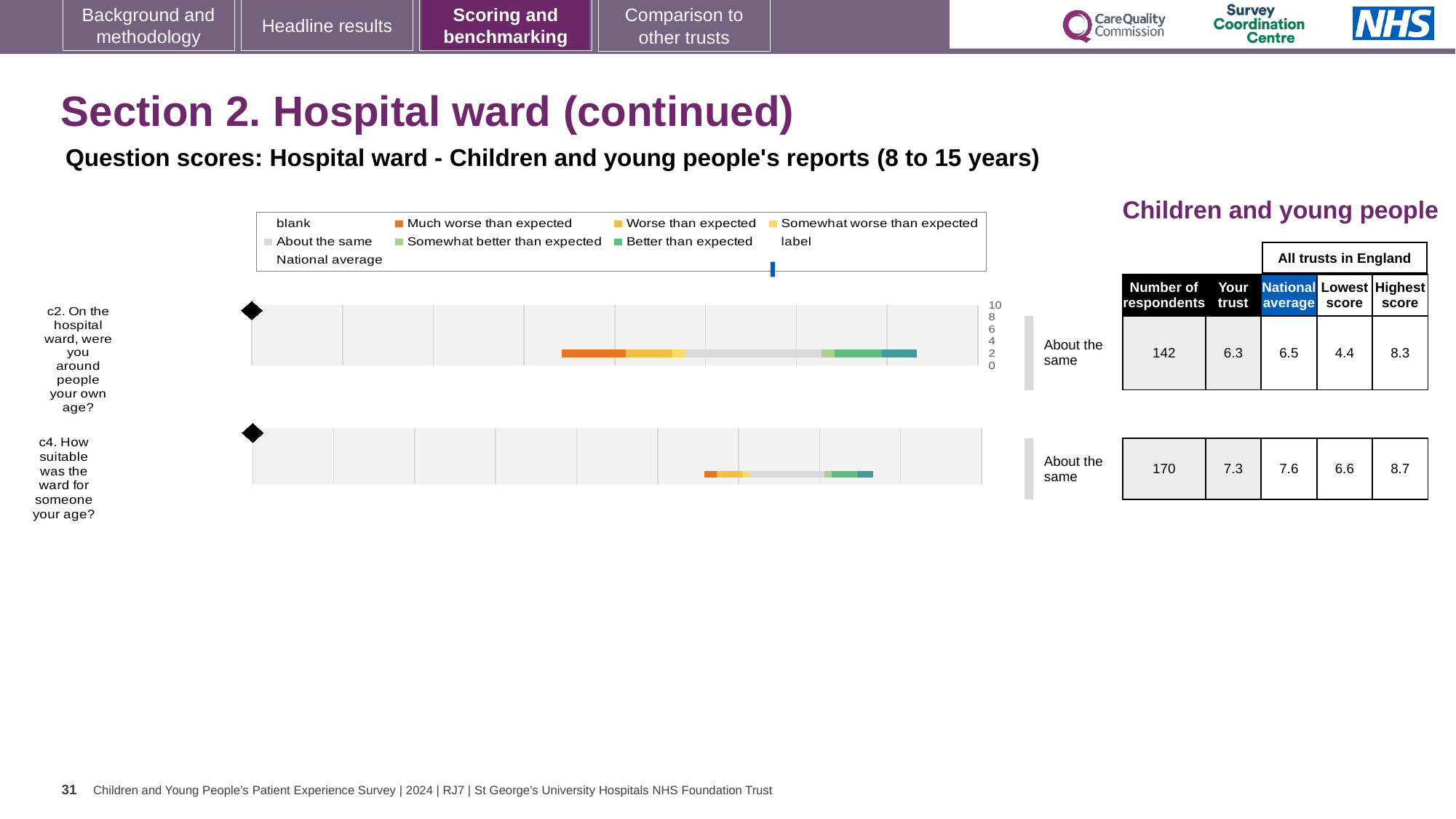
What is the national average score for question c4 (How suitable was the ward for someone your age?)? 7.6 How many respondents answered question c4? 170 What is the difference between the national average and the trust's score for question c2? 0.2 What is the 'Your trust' score for question c2 (On the hospital ward, were you around people your own age?)? 6.3 What kind of chart is used to show the question scores on this slide? bar chart Which question has the lowest 'Lowest score' across all trusts in England? c2 Which question has the higher 'Your trust' score, c2 or c4? c4 What benchmarking category is the trust given for question c4? About the same What is the difference between the highest and lowest scores for question c4? 2.1 Which legend entry is shown in orange? Much worse than expected How many questions (categories) are plotted in the chart? 2 What is the highest score among all trusts in England for question c2? 8.3